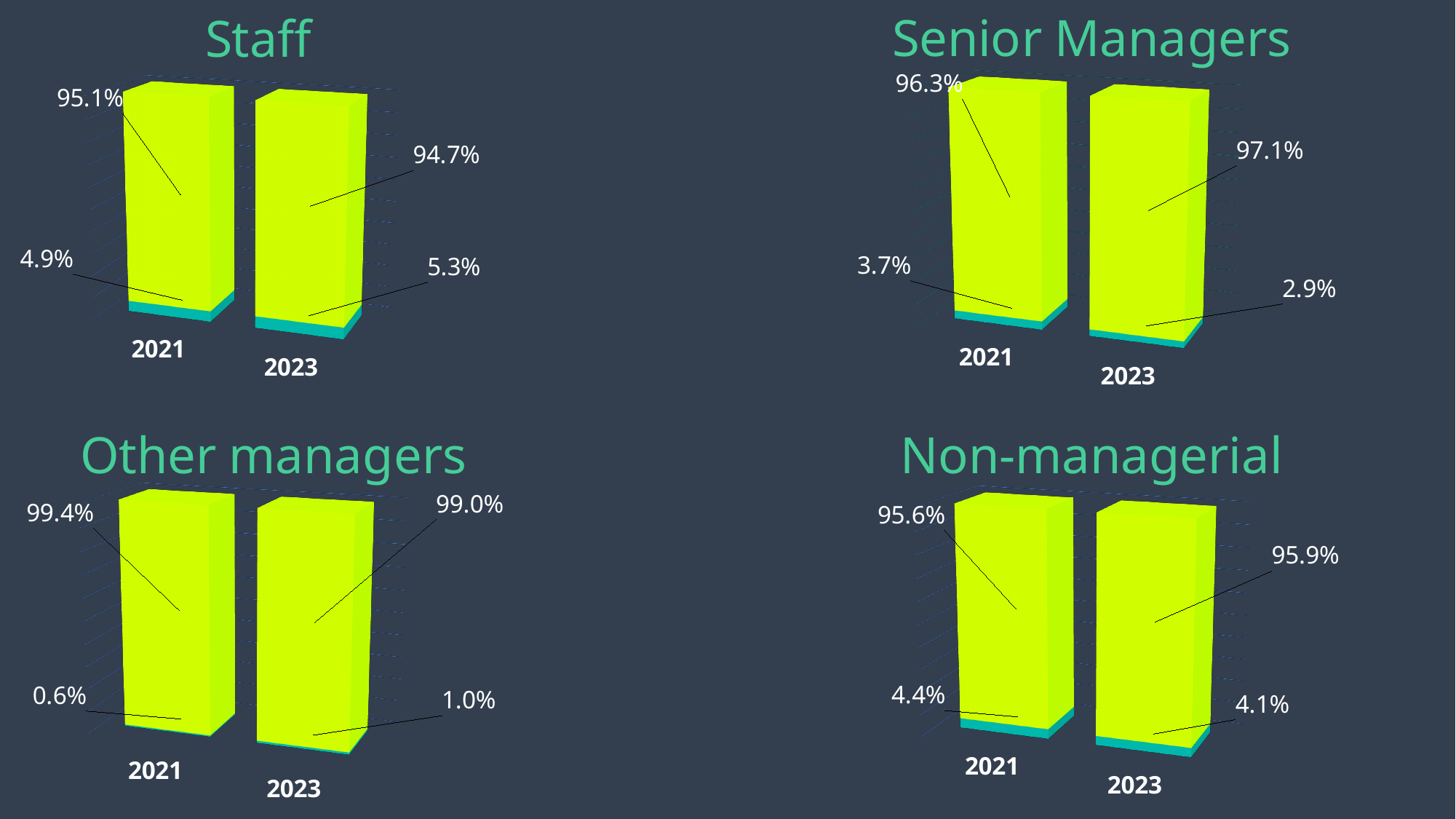
How many categories (years) are shown in the Non-managerial chart? 2 In the Other managers chart, does the larger (yellow) value rise or fall from 2021 to 2023? fall How many charts are shown on the slide? 4 In the Non-managerial chart, what is the larger (yellow) value for 2021? 95.6% In the Staff chart, which year has the larger smaller (teal) value, 2021 or 2023? 2023 In the Senior Managers chart, what is the smaller (teal) value for 2021? 3.7% What kind of chart is the Staff chart? bar chart In the Senior Managers chart, what is the difference between the smaller (teal) values for 2021 and 2023? 0.8% In the Staff chart, what is the smaller (teal) value for 2023? 5.3% In the Senior Managers chart, what is the larger (yellow) value for 2023? 97.1% In the Staff chart, what is the larger (yellow) value for 2021? 95.1% In the Other managers chart, what is the smaller (teal) value for 2023? 1.0%